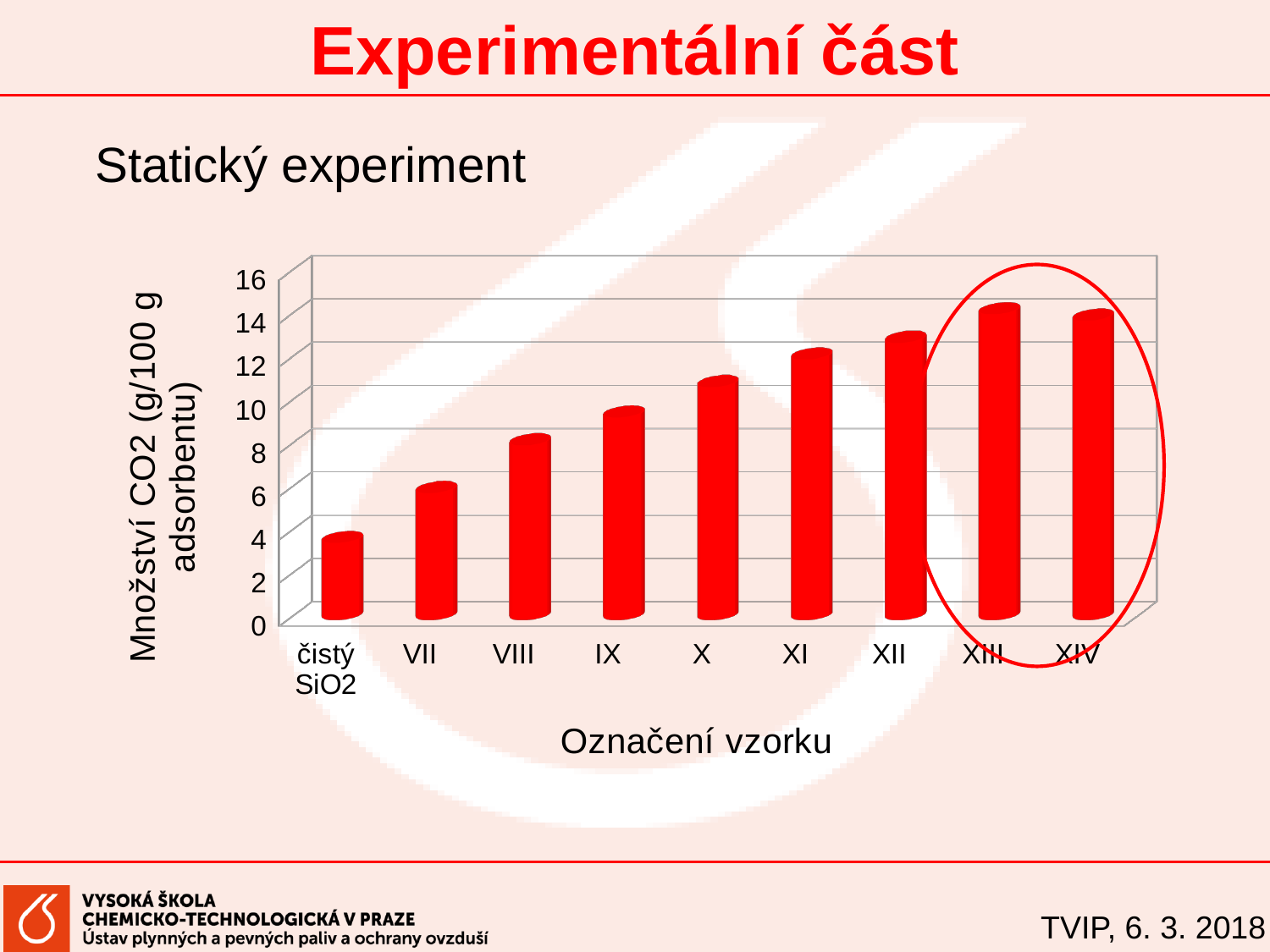
Do the values generally rise or fall from čistý SiO2 to XIII along the x axis? rise What kind of chart is shown on the slide? bar chart Which has a larger value, sample XII or sample VII? XII What is the title of the y axis? Množství CO2 (g/100 g adsorbentu) How many samples (categories) are plotted on the x axis? 9 Is the value for sample VII greater or less than 10? less Is the value for čistý SiO2 greater or less than 6? less Is the value for sample XI greater or less than 10? greater Which sample has the lowest amount of adsorbed CO2? čistý SiO2 What is the title of the x axis? Označení vzorku